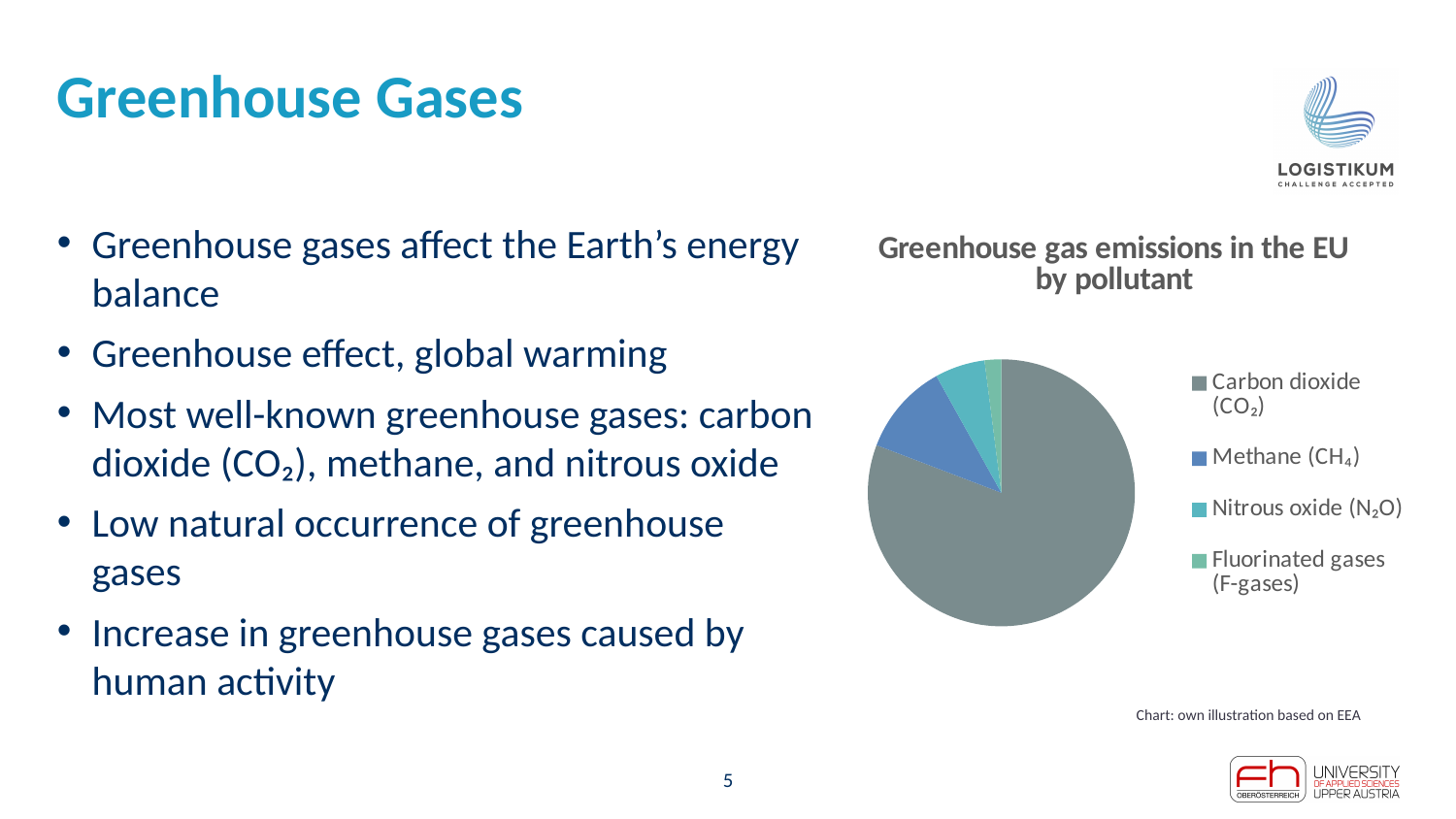
How many entries does the chart legend list? 4 Which legend entry is listed first in the chart legend? Carbon dioxide (CO₂) How many categories does the pie chart show? 4 Which pollutant has the largest slice of the pie? Carbon dioxide (CO₂) Which slice is larger, Methane (CH₄) or Nitrous oxide (N₂O)? Methane (CH₄) Which pollutant has the smallest slice of the pie? Fluorinated gases (F-gases) Which slice is larger, Carbon dioxide (CO₂) or Methane (CH₄)? Carbon dioxide (CO₂) What is the title of the chart? Greenhouse gas emissions in the EU by pollutant What kind of chart is shown on the slide? pie chart Which slice is larger, Nitrous oxide (N₂O) or Fluorinated gases (F-gases)? Nitrous oxide (N₂O)